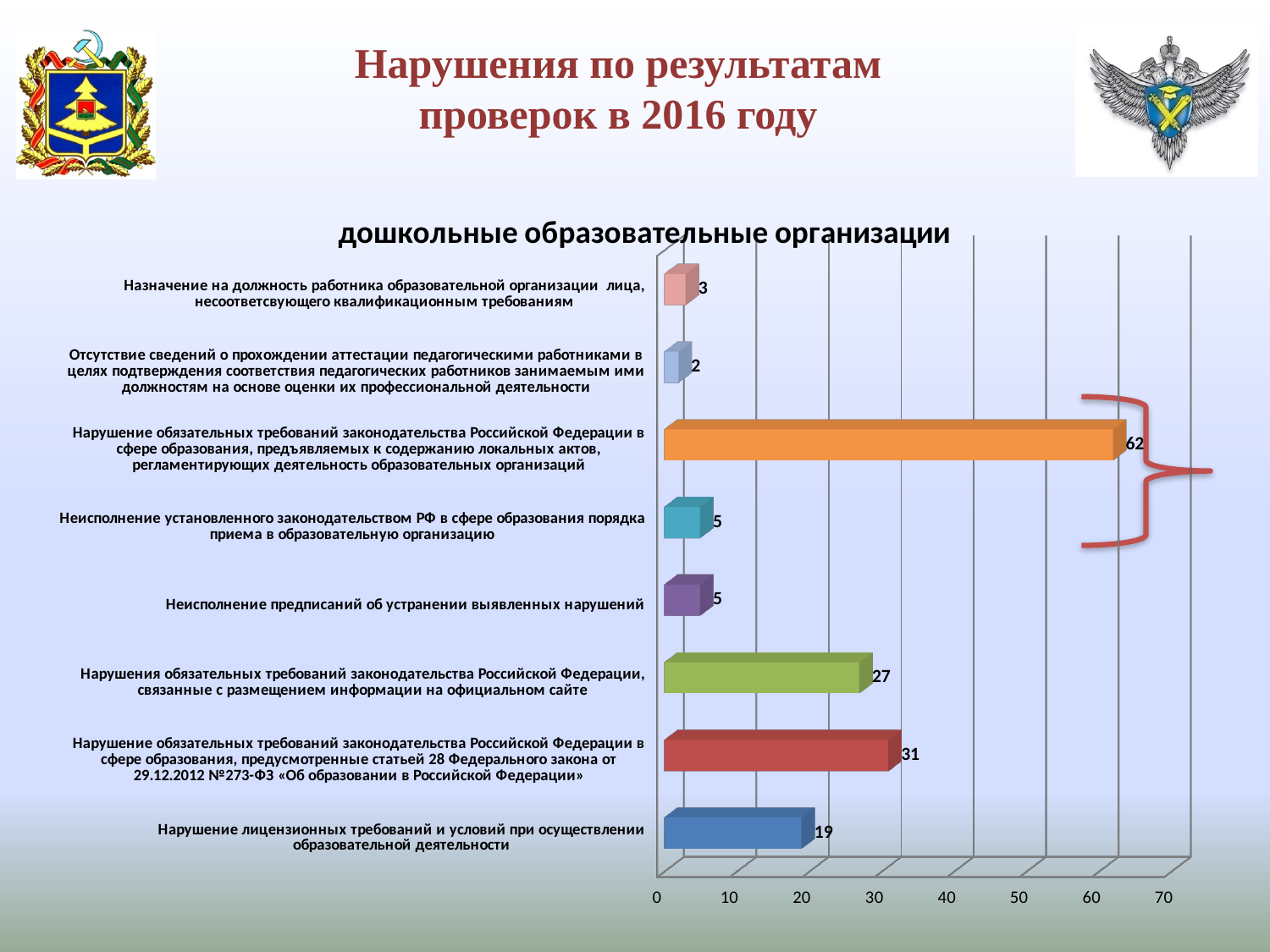
What is the value for "Неисполнение предписаний об устранении выявленных нарушений"? 5 What is the difference between the value for violations related to the content of local acts (62) and the value for violations under Article 28 of Federal Law No. 273-ФЗ (31)? 31 Which category has the highest value? Нарушение обязательных требований законодательства Российской Федерации в сфере образования, предъявляемых к содержанию локальных актов, регламентирующих деятельность образовательных организаций What is the value for "Нарушение лицензионных требований и условий при осуществлении образовательной деятельности"? 19 What is the title of the chart? дошкольные образовательные организации What is the value for "Нарушения обязательных требований законодательства Российской Федерации, связанные с размещением информации на официальном сайте"? 27 Which is larger: the value for "Нарушение лицензионных требований..." or the value for "Нарушения обязательных требований..., связанные с размещением информации на официальном сайте"? Нарушения обязательных требований..., связанные с размещением информации на официальном сайте What is the value for "Назначение на должность работника образовательной организации лица, несоответсвующего квалификационным требованиям"? 3 What kind of chart is shown on the slide? bar chart How many categories (types of violations) are plotted in the chart? 8 Is the value for "Нарушение обязательных требований законодательства Российской Федерации в сфере образования, предусмотренные статьей 28 Федерального закона от 29.12.2012 №273-ФЗ" greater or less than 30? greater